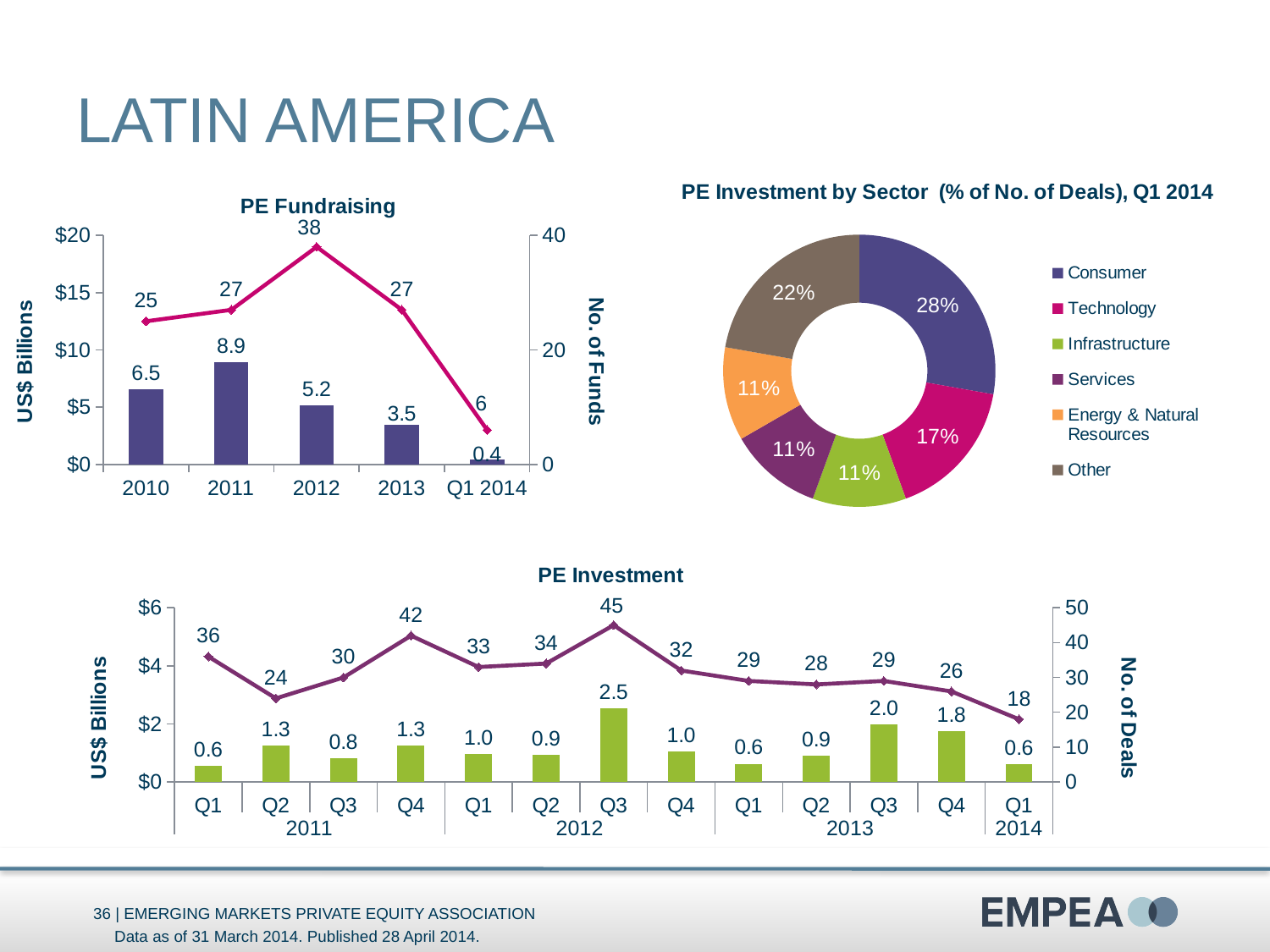
What type of chart is the PE Investment by Sector chart? Donut chart In the PE Fundraising chart, how many categories are shown on the x axis? 5 In the PE Fundraising chart, what is the difference in US$ billions between fundraising in 2012 and 2013? 1.7 In the PE Investment chart, is the number of deals in Q4 2011 larger or smaller than in Q2 2011? larger In the PE Investment chart, how many deals were there in Q3 2012? 45 In the PE Fundraising chart, how many US$ billions were raised in 2011? 8.9 In the PE Fundraising chart, how many funds were there in 2012? 38 In the PE Investment by Sector chart, how many sectors does the legend list? 6 In the PE Investment by Sector chart, which sector has the smallest share other than the three tied at 11%? Technology In the PE Fundraising chart, which year had the highest fundraising in US$ billions? 2011 In the PE Investment chart, which quarter had the highest investment in US$ billions? Q3 2012 In the PE Investment by Sector chart, what share of deals was in Consumer? 28%